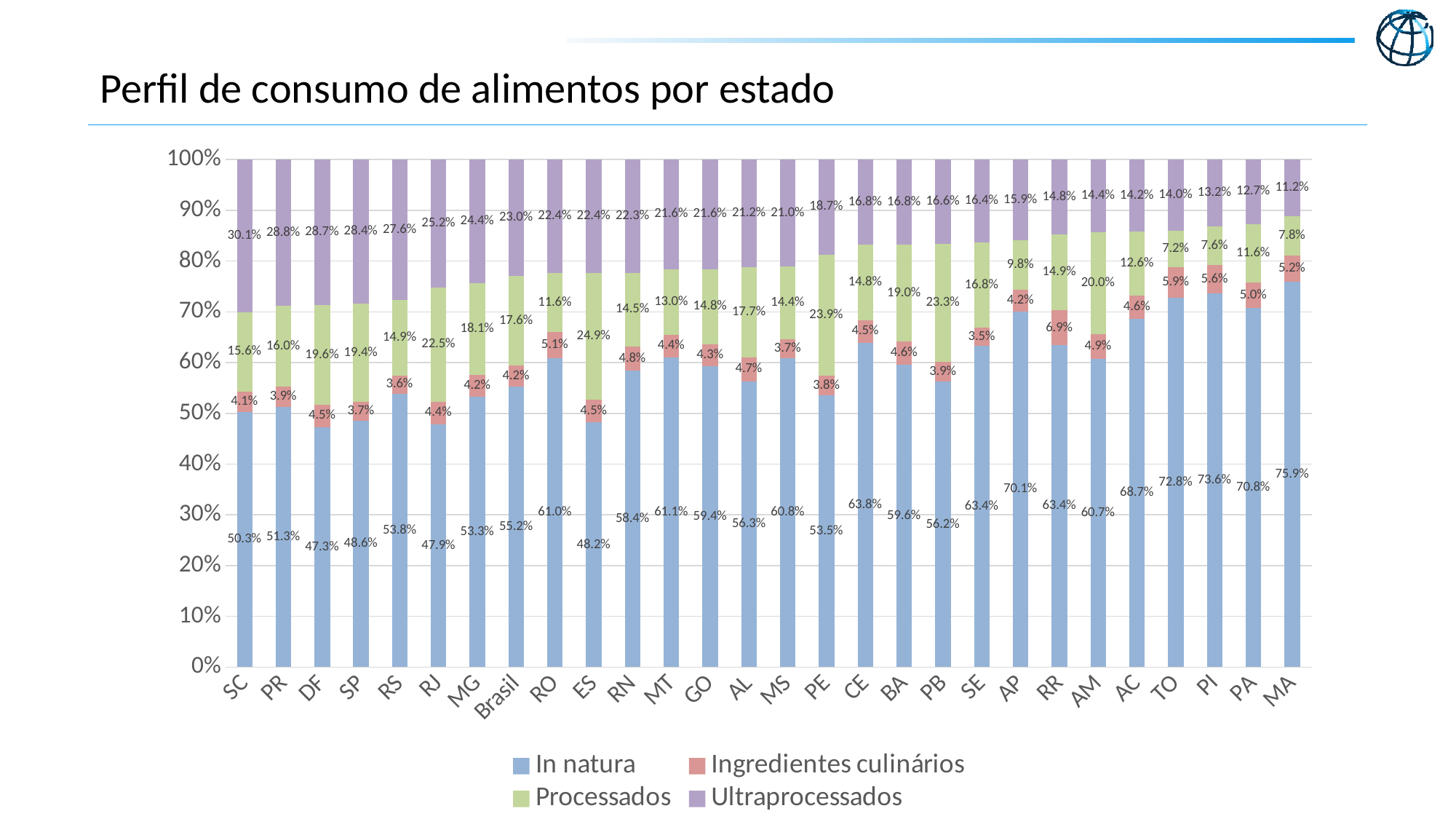
What is the In natura value for Brasil? 55.2% Which category has the lowest In natura value? DF Do the Ultraprocessados values rise or fall from left to right along the x axis? fall Which state has the lowest Ultraprocessados value? MA How many series does the legend list? 4 What is the difference between the Ultraprocessados value for SC and for MA? 18.9 percentage points Which is larger, the In natura value for RS or for SP? RS What is the Ingredientes culinários value for RR? 6.9% Which state has the highest In natura value? MA How many categories are shown on the x axis? 28 What is the Processados value for ES? 24.9% What is the Ultraprocessados value for SC? 30.1%